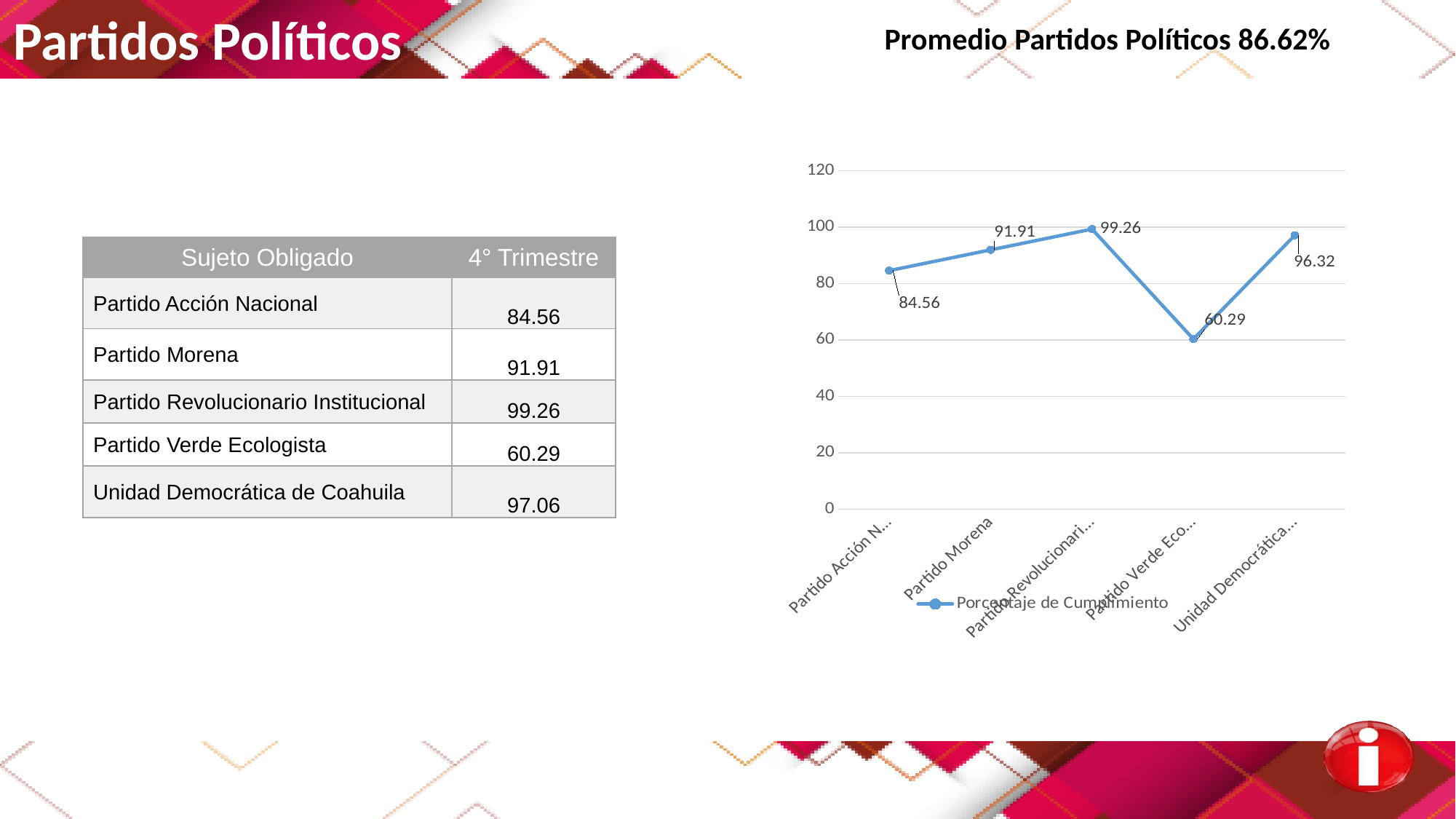
Which category has the lowest value in the chart? Partido Verde Ecologista What is the value plotted for Partido Acción Nacional in the chart? 84.56 What series name does the chart legend show? Porcentaje de Cumplimiento Is the value for Partido Verde Ecologista in the chart greater or less than 80? less What is the data label shown for Unidad Democrática de Coahuila in the chart? 96.32 How many categories are plotted in the chart? 5 What type of chart is shown on the slide? line chart What is the difference between the values for Partido Revolucionario Institucional and Partido Verde Ecologista in the chart? 38.97 Which is larger in the chart, the value for Partido Morena or the value for Partido Acción Nacional? Partido Morena Which category has the highest value in the chart? Partido Revolucionario Institucional What is the value plotted for Partido Morena in the chart? 91.91 What is the value plotted for Partido Verde Ecologista in the chart? 60.29